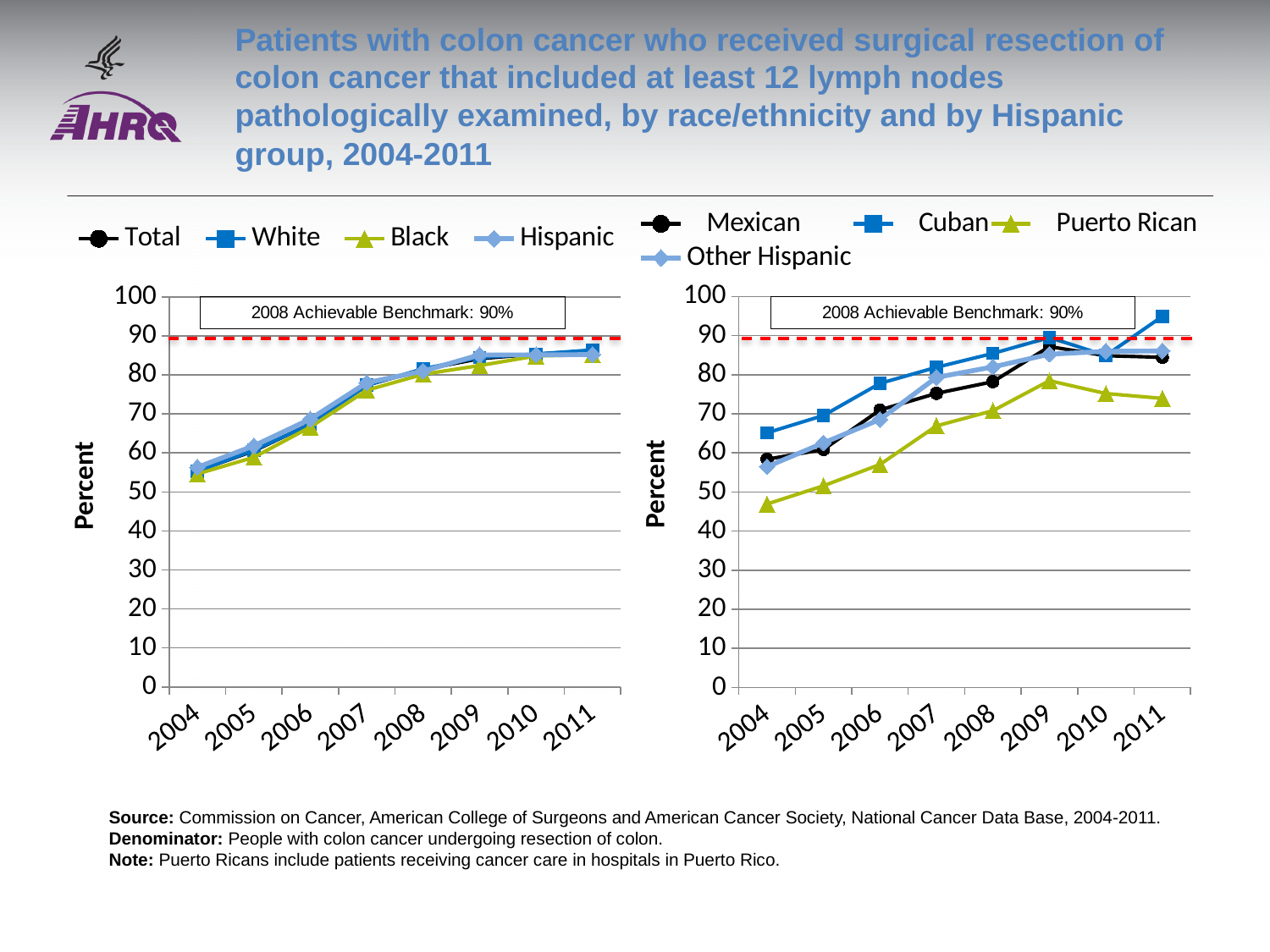
In the left chart, do the values for Total rise or fall from 2004 to 2011? Rise In the right chart, which Hispanic group has the highest value in 2004? Cuban How many series does the legend of the right chart (Hispanic groups) list? 4 How many years are shown on the x axis of the left chart? 8 In the left chart, is the value for Black in 2004 greater or less than 60? less What is the 2008 Achievable Benchmark shown on both charts? 90% What kind of chart is the left chart (Total, White, Black, Hispanic)? Line chart In the left chart, is the value for White in 2011 greater or less than 80? greater In the right chart, which Hispanic group has the lowest value in 2011? Puerto Rican In the right chart, which is larger in 2011, the value for Cuban or the value for Puerto Rican? Cuban In the right chart, is the value for Puerto Rican in 2004 greater or less than 50? less